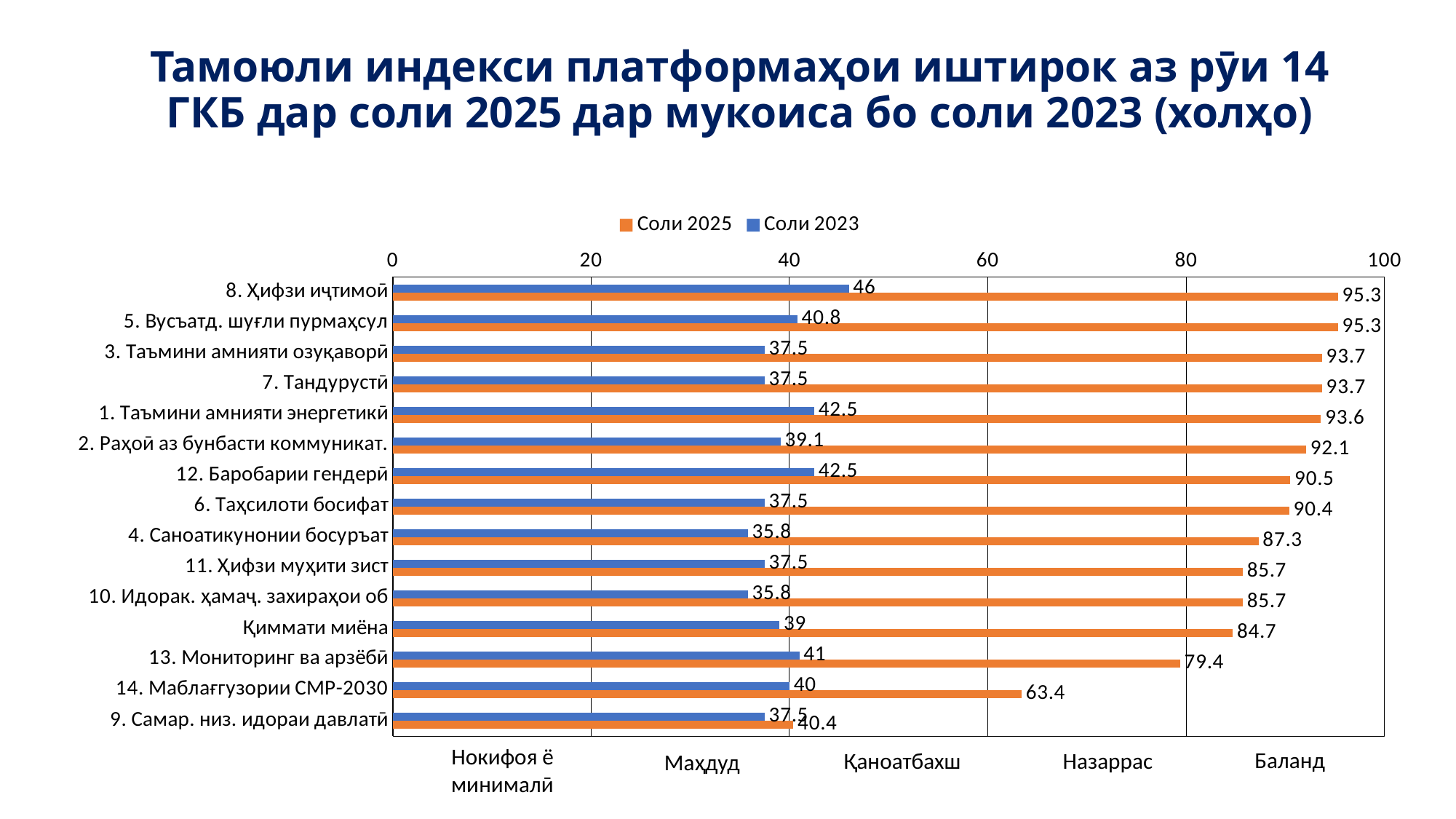
How many categories are shown on the chart? 15 Which category has the highest Соли 2023 value? 8. Ҳифзи иҷтимоӣ Which category has the lowest Соли 2025 value? 9. Самар. низ. идораи давлатӣ What is the Соли 2025 value for 8. Ҳифзи иҷтимоӣ? 95.3 How many series does the legend list? 2 Which is larger: the Соли 2025 value for 14. Маблағгузории СМР-2030 or for 13. Мониторинг ва арзёбӣ? 13. Мониторинг ва арзёбӣ What is the Соли 2023 value for 1. Таъмини амнияти энергетикӣ? 42.5 What kind of chart is shown on the slide? Bar chart What is the Соли 2025 value for Қиммати миёна? 84.7 What is the Соли 2023 value for 14. Маблағгузории СМР-2030? 40 Which colour represents the Соли 2025 series? Orange What is the difference between the Соли 2025 and Соли 2023 values for 13. Мониторинг ва арзёбӣ? 38.4